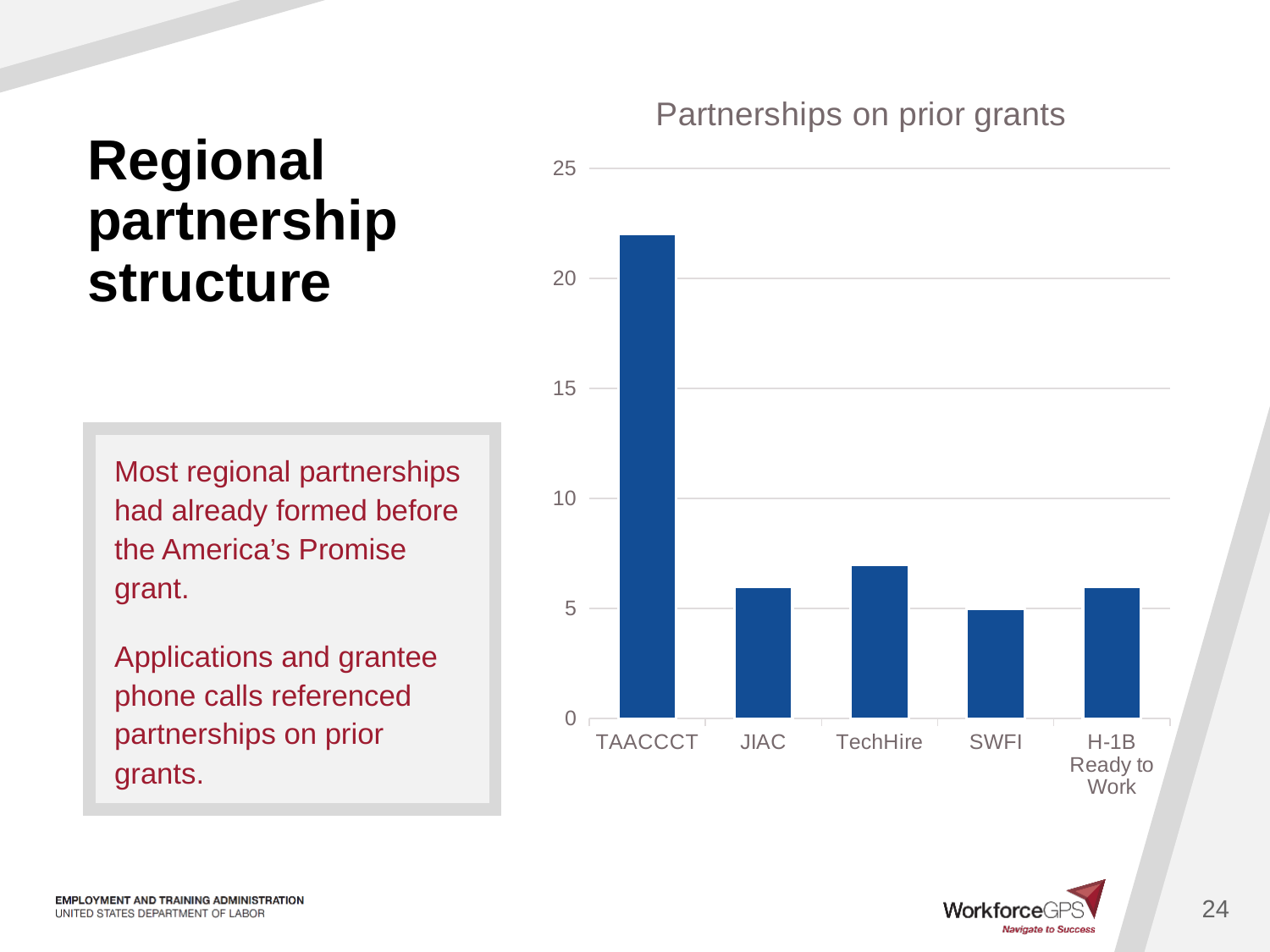
What is the title of the chart? Partnerships on prior grants Is the value for JIAC greater or less than 10? less Which is larger, the value for TAACCCT or the value for TechHire? TAACCCT What kind of chart is shown on the slide? bar chart How many categories are shown on the x axis of the chart? 5 Is the value for TAACCCT greater or less than 20? greater What colour are the bars in the chart? blue Which category has the lowest value in the chart? SWFI Is the value for H-1B Ready to Work greater or less than 10? less Which is larger, the value for TechHire or the value for SWFI? TechHire Which category has the highest value in the chart? TAACCCT